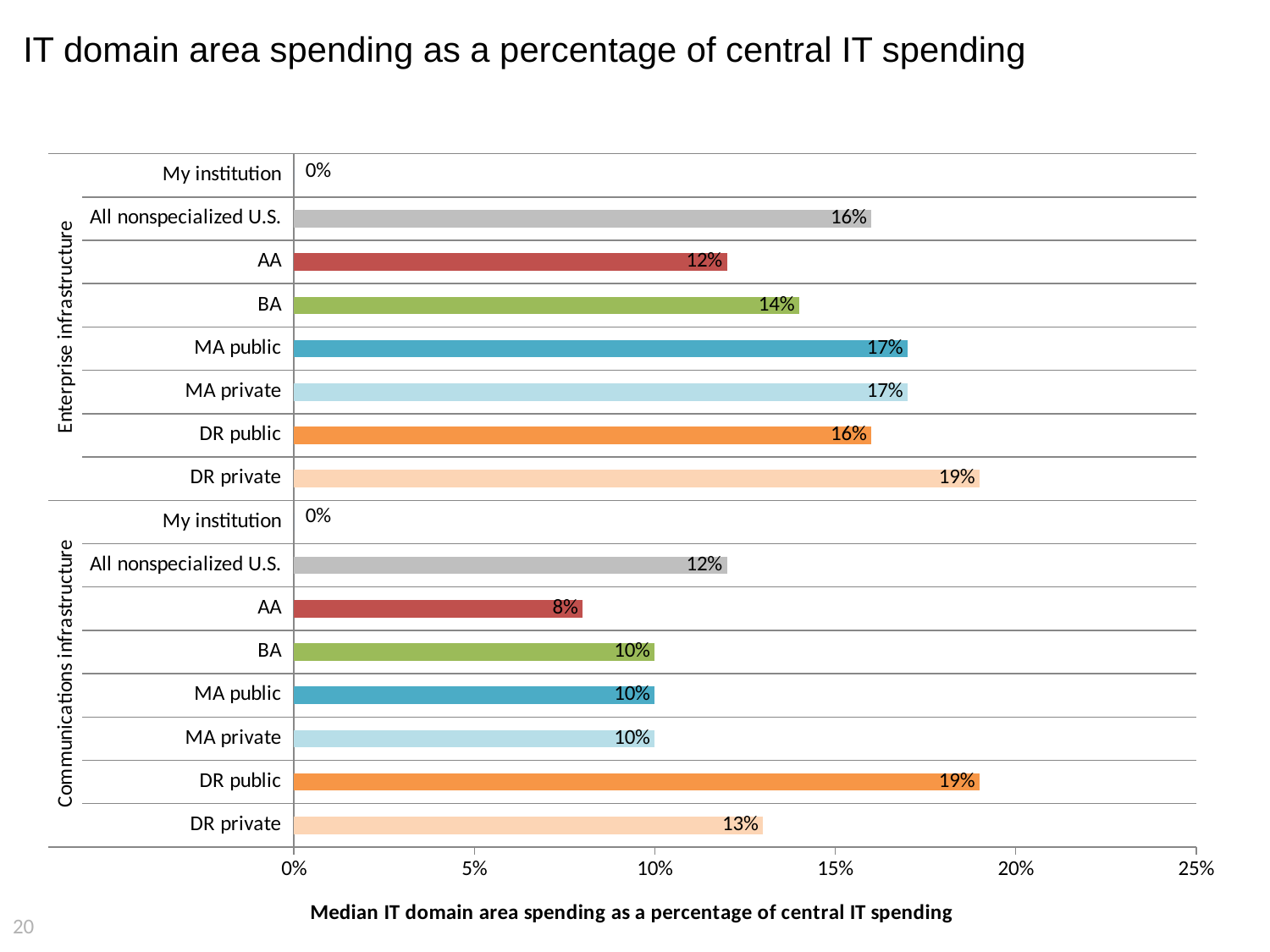
Which is larger: the Communications infrastructure value for All nonspecialized U.S. or for BA? All nonspecialized U.S. What is the label on the horizontal axis of the chart? Median IT domain area spending as a percentage of central IT spending How many bars (categories) are plotted in the Enterprise infrastructure group? 8 What kind of chart is shown on the slide? Bar chart What is the value for DR private under Enterprise infrastructure? 19% What is the value for AA under Communications infrastructure? 8% Which category has the highest value in the Enterprise infrastructure group? DR private What is the difference between the Enterprise infrastructure values for DR private and AA? 7% What is the value for All nonspecialized U.S. under Enterprise infrastructure? 16% Excluding My institution, which category has the lowest value in the Communications infrastructure group? AA Which category has the highest value in the Communications infrastructure group? DR public What is the value for DR private under Communications infrastructure? 13%